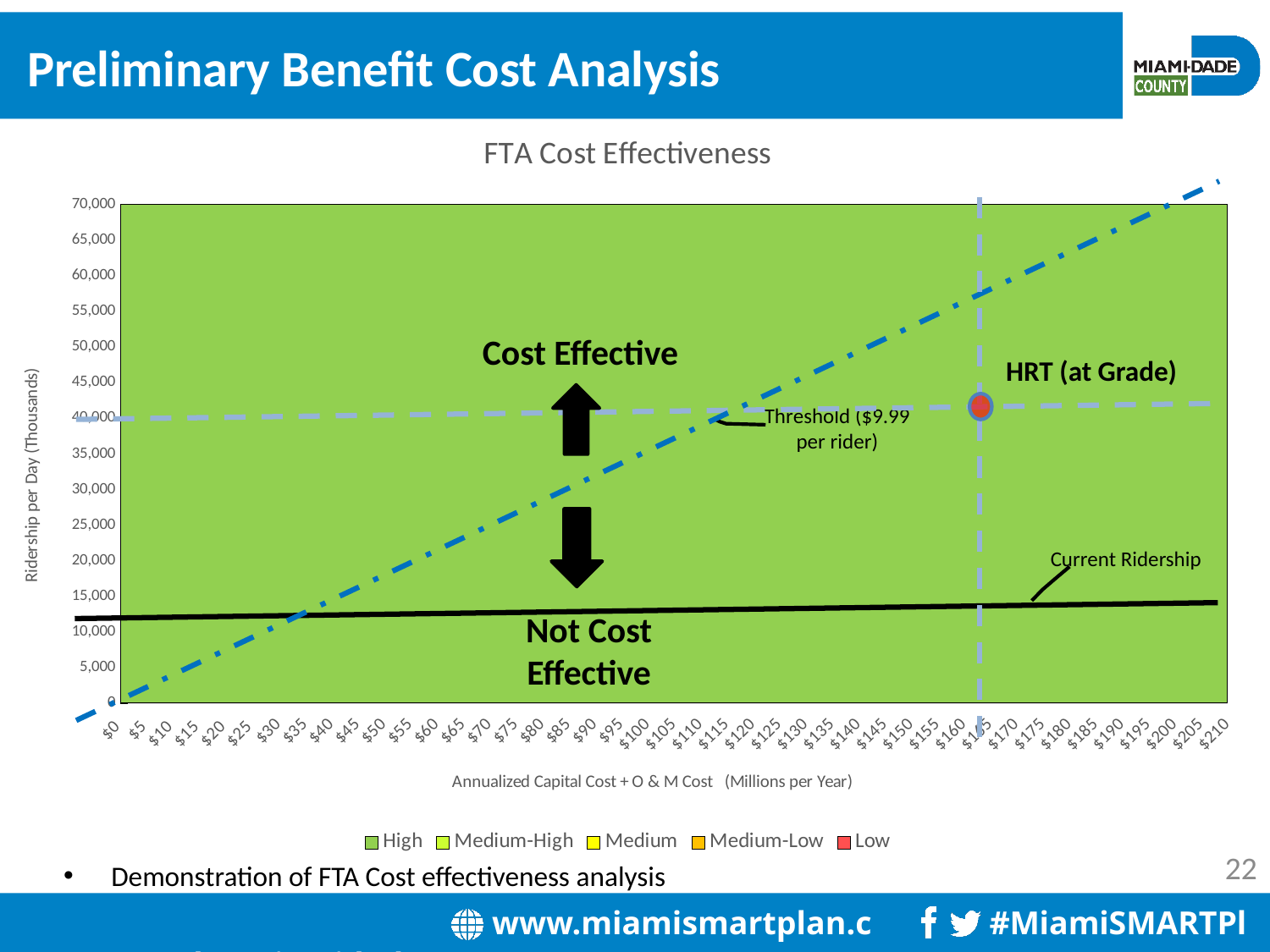
What is the highest value shown on the vertical axis of the chart? 70,000 What is the title of the chart? FTA Cost Effectiveness Is the Current Ridership line greater or less than 15,000 riders per day? less Is the ridership value for the HRT (at Grade) point greater or less than 30,000? greater Which is higher on the chart: the HRT (at Grade) point or the Current Ridership line? HRT (at Grade) What cost-per-rider threshold is annotated on the chart? $9.99 per rider Is the ridership value for the HRT (at Grade) point greater or less than 50,000? less What is the label of the vertical axis of the chart? Ridership per Day (Thousands) Does the dashed blue threshold line rise or fall as the annualized cost increases along the x axis? rise How many entries does the chart's legend list? 5 What is the highest value shown on the horizontal axis of the chart? $210